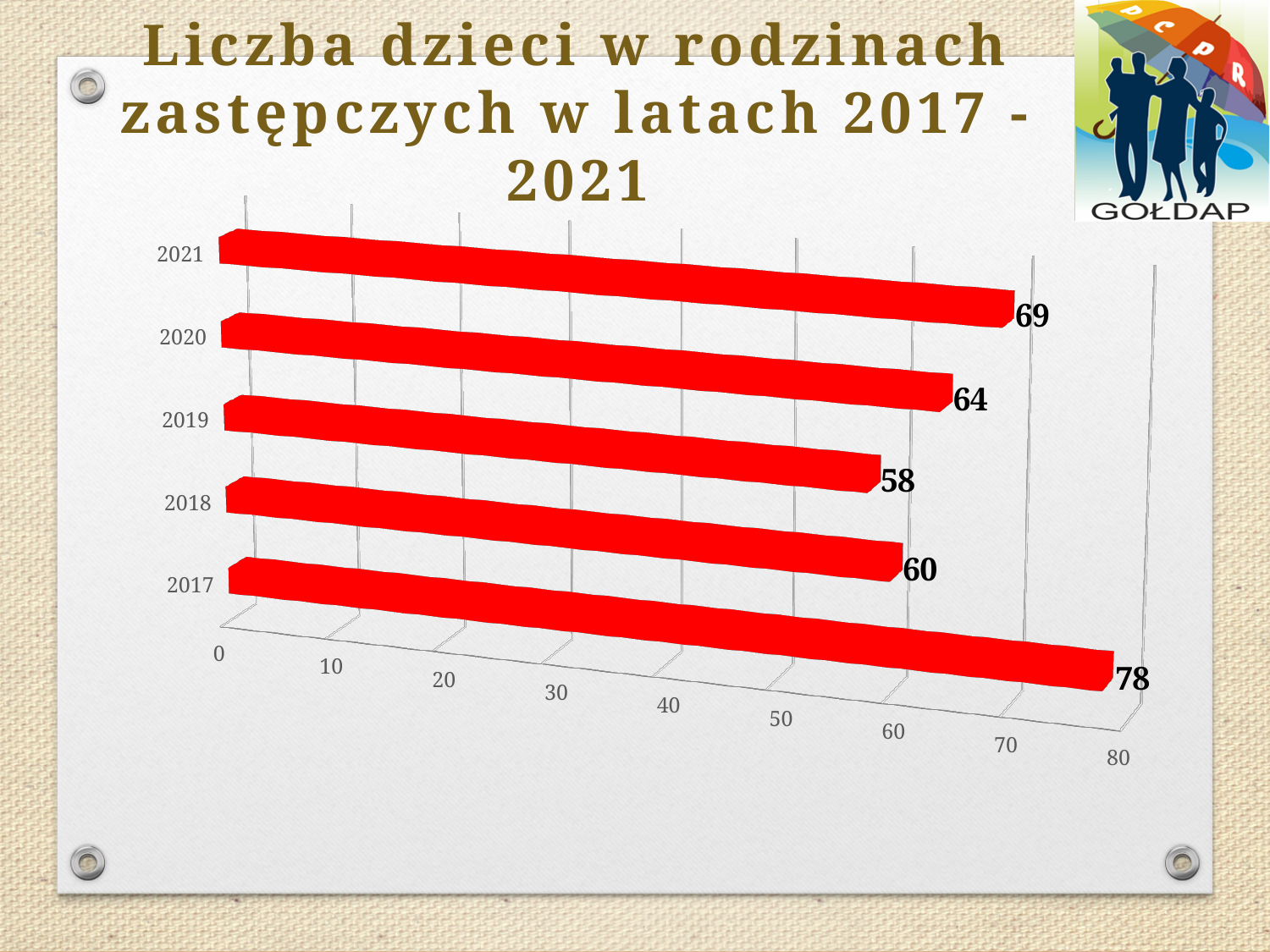
Which year has the lowest value? 2019 Which is larger, the value for 2018 or the value for 2020? 2020 Is the value for 2018 greater or less than 70? less What is the value for 2019? 58 What is the difference between the values for 2017 and 2021? 9 Which year has the highest value? 2017 What is the value for 2017? 78 How many years are shown on the chart? 5 What is the title of the chart? Liczba dzieci w rodzinach zastępczych w latach 2017 - 2021 What is the value for 2021? 69 What kind of chart is shown on the slide? bar chart What is the difference between the values for 2020 and 2019? 6